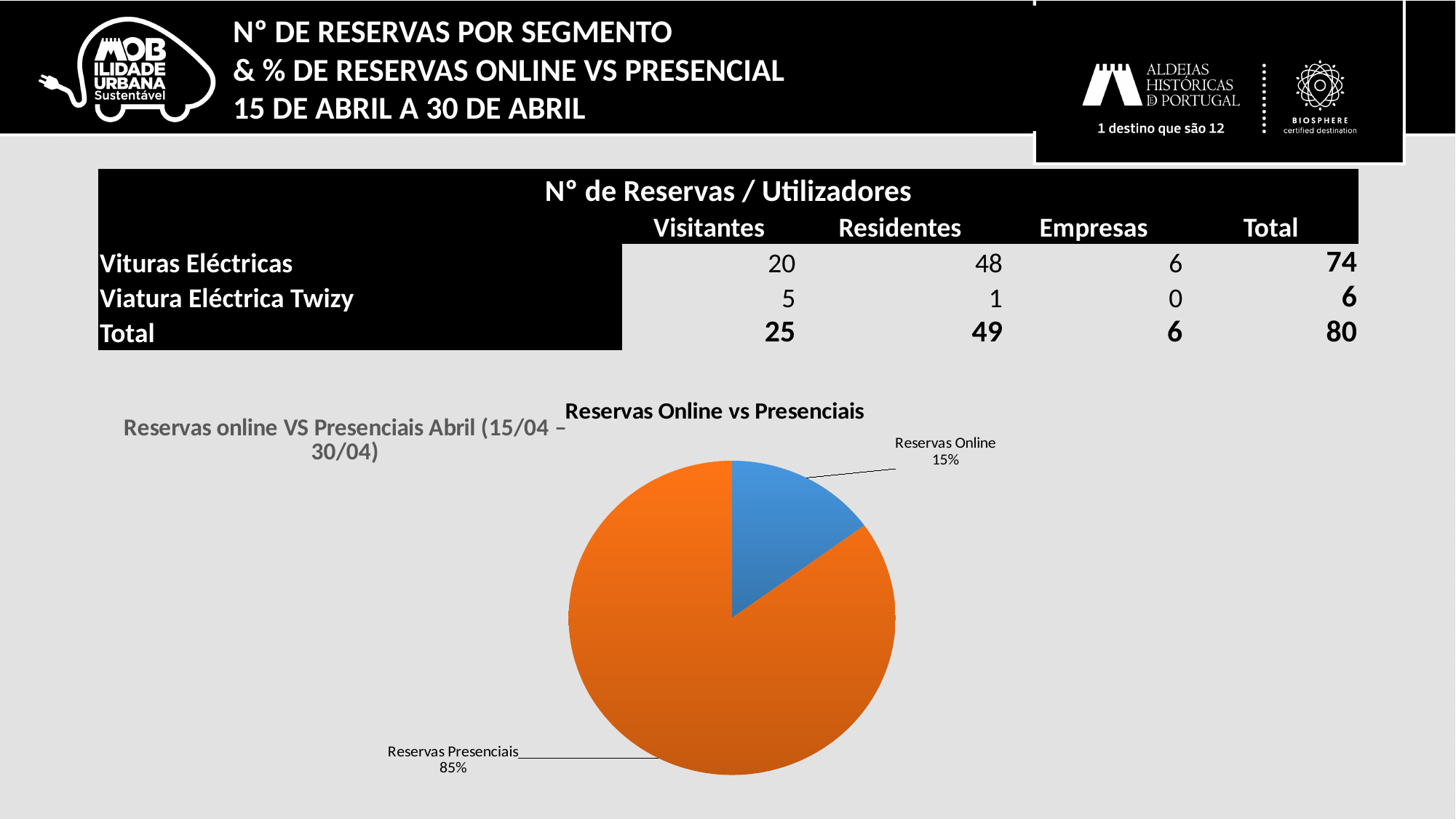
What is the title of the pie chart? Reservas Online vs Presenciais Which is larger in the pie chart, Reservas Online or Reservas Presenciais? Reservas Presenciais How many slices does the pie chart have? 2 What is the difference in percentage points between Reservas Presenciais and Reservas Online in the pie chart? 70 What share of the pie chart is Reservas Presenciais? 85% What share of the pie chart is Reservas Online? 15% What colour is the Reservas Online slice in the pie chart? blue What kind of chart is shown on the slide? pie chart Which slice of the pie chart is the largest? Reservas Presenciais Which slice of the pie chart is the smallest? Reservas Online